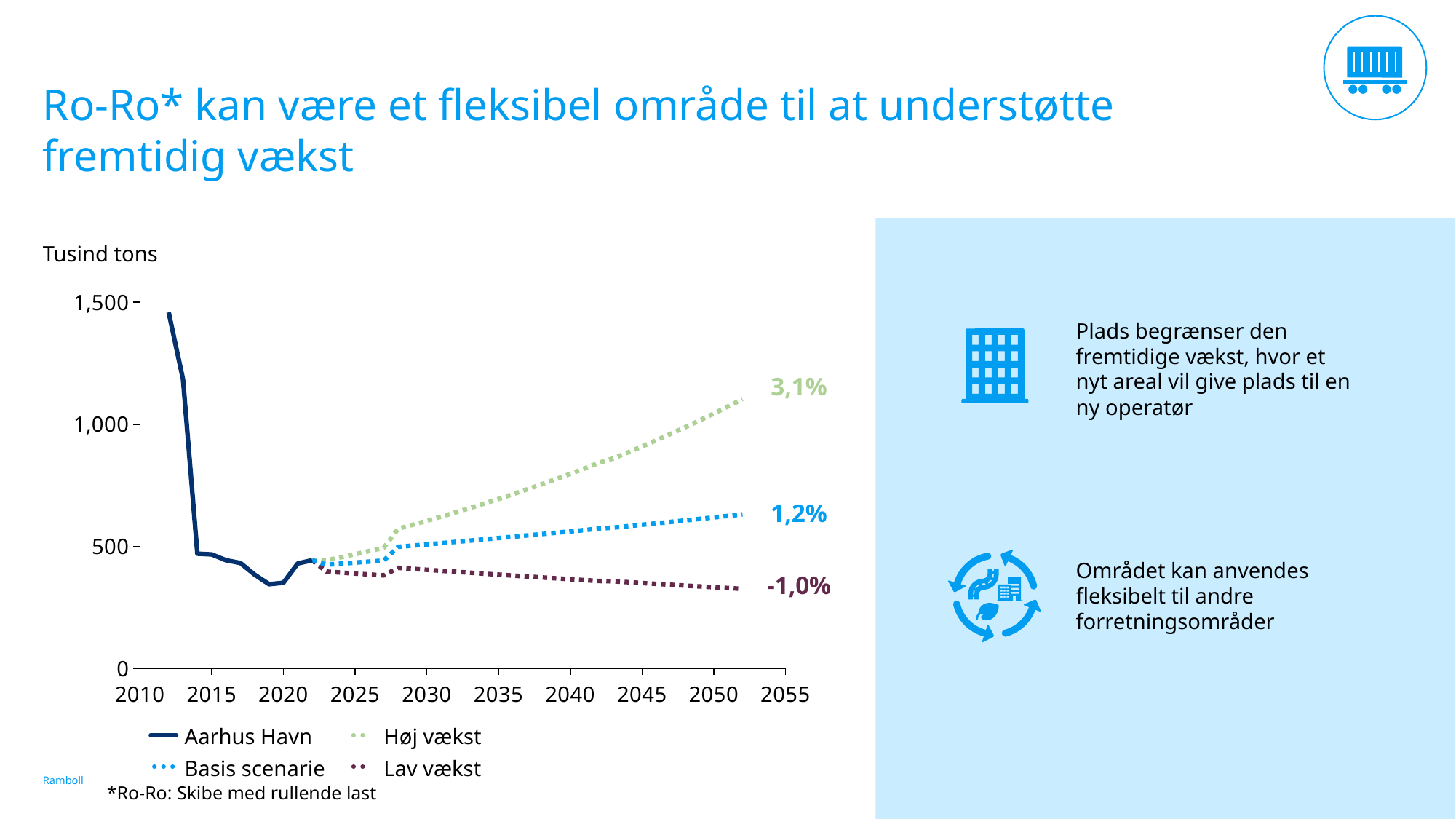
Is the value of the Høj vækst line at its end point (around 2052) greater or less than 1,000? greater How many series does the chart legend list? 4 Is the first value of the Aarhus Havn line (around 2012) greater or less than 1,000? greater Does the Aarhus Havn line rise or fall between 2012 and 2014? fall What unit is shown above the y axis of the chart? Tusind tons What annual growth rate is printed next to the Lav vækst line? -1,0% What kind of chart is shown on the slide? line chart At the end of the projection (around 2052), which line is higher: Høj vækst or Lav vækst? Høj vækst What annual growth rate is printed next to the Basis scenarie line? 1,2% What annual growth rate is printed next to the Høj vækst line? 3,1% Is the value of the Lav vækst line at its end point (around 2052) greater or less than 500? less Does the Lav vækst line rise or fall from 2022 to 2052? fall